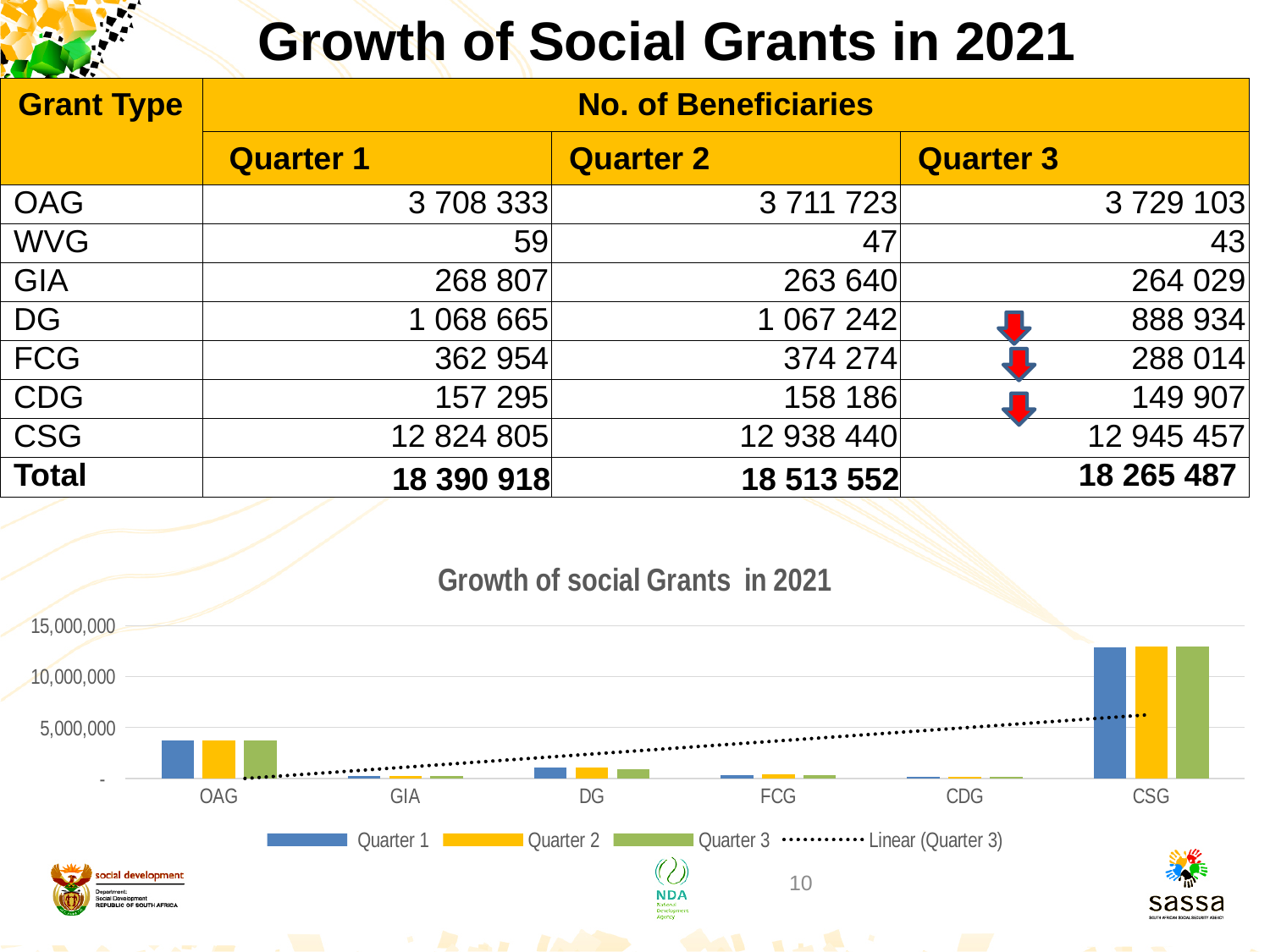
Which grant type has the highest bars in the chart? CSG How many entries does the chart legend list? 4 Which colour represents Quarter 2 in the chart? yellow In the chart, which has the larger Quarter 3 value, CSG or OAG? CSG What is the title of the chart? Growth of social Grants in 2021 Is the Quarter 1 value for OAG in the chart greater or less than 5,000,000? less What kind of chart is shown on the slide? bar chart In the chart, which has the larger Quarter 1 value, OAG or DG? OAG How many grant types are shown on the x axis of the chart? 6 Is the Quarter 2 value for DG in the chart greater or less than 5,000,000? less Is the Quarter 1 value for CSG in the chart greater or less than 15,000,000? less